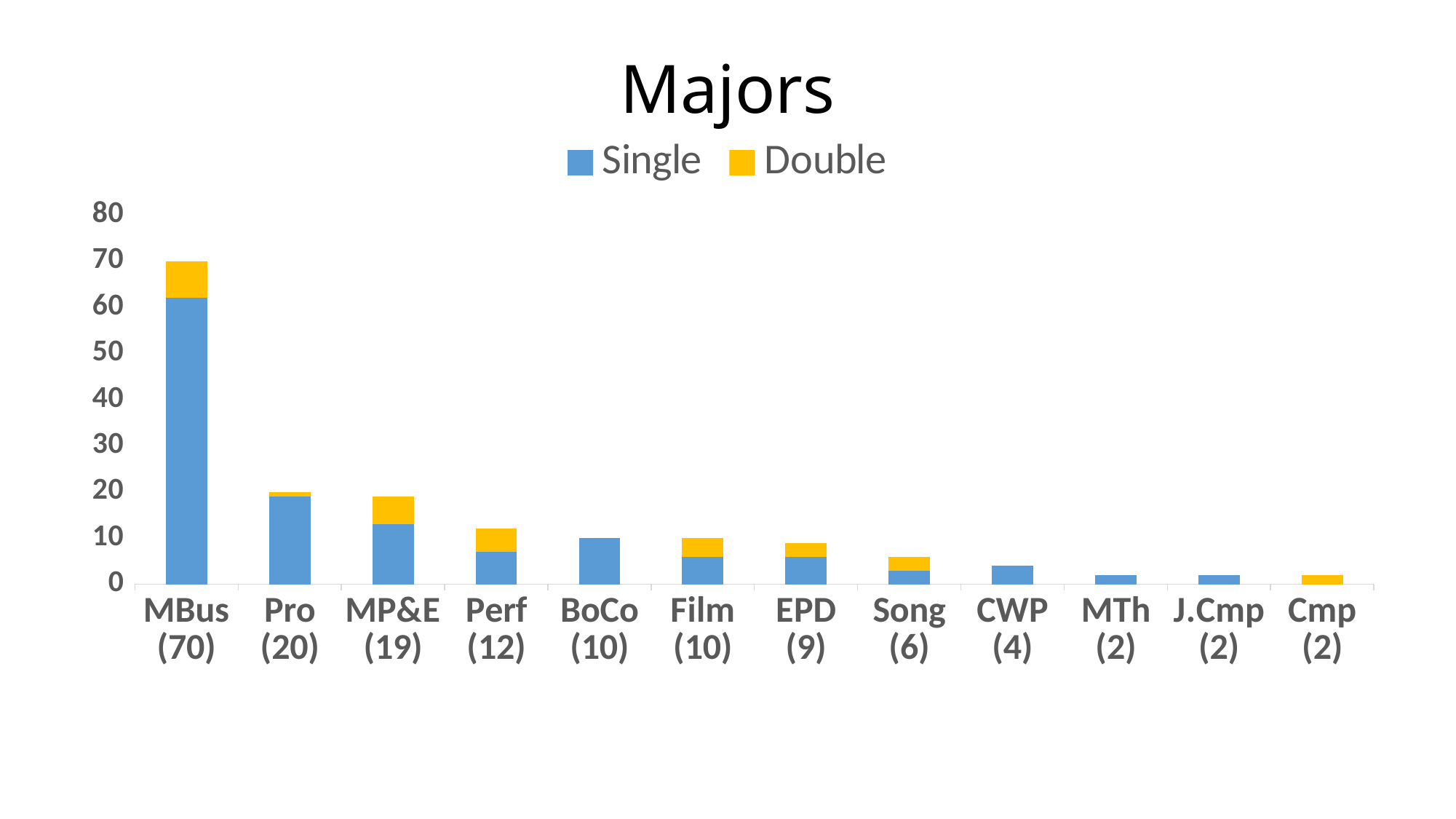
What kind of chart is shown on the slide? bar chart Do the totals rise or fall moving from left to right along the x axis? fall What is the total shown for Song? 6 What colour represents the Double series in the legend? yellow How many majors (categories) are shown on the x axis? 12 Which has the larger total, Pro or MP&E? Pro What is the difference between the totals for MBus and Pro? 50 Is the Single value for Perf greater or less than 10? less What is the total shown for MBus? 70 How many series does the legend list? 2 Which major has the highest total? MBus Is the Single value for MBus greater or less than 50? greater